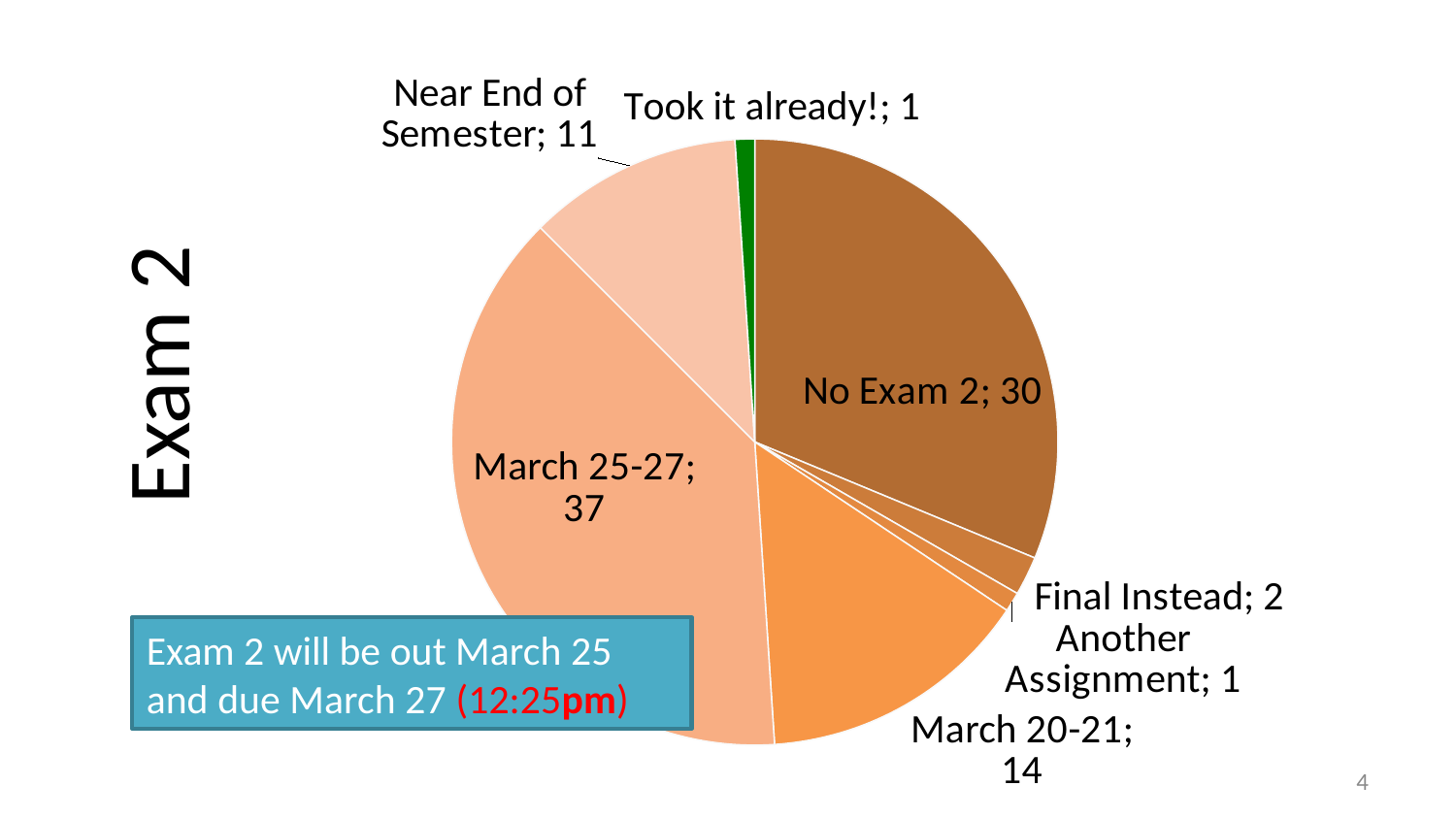
Which is larger, 'March 20-21' or 'Near End of Semester'? March 20-21 How many slices (categories) does the pie chart have? 7 What is the value for the 'March 25-27' slice? 37 What is the value for 'Final Instead'? 2 What type of chart is shown on the slide? pie chart What is the value for the 'No Exam 2' slice? 30 What is the total of all the slice values in the pie chart? 96 Which categories have the smallest value in the pie chart? Another Assignment and Took it already! What is the value for 'March 20-21'? 14 Which category has the largest slice of the pie? March 25-27 What is the difference between the 'March 25-27' value and the 'No Exam 2' value? 7 What is the value for 'Near End of Semester'? 11